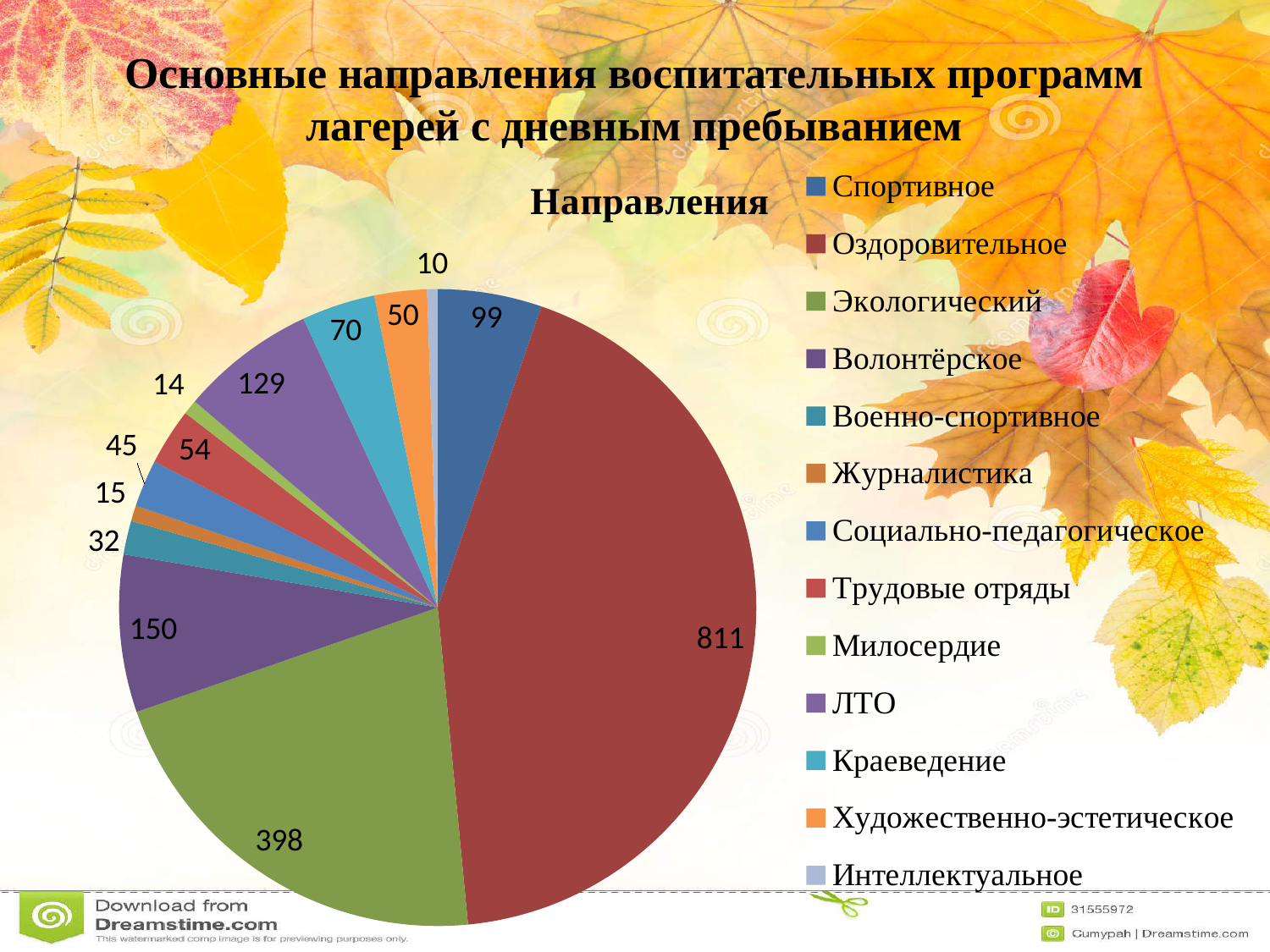
What is the value for Оздоровительное? 811 What is the difference between the values for Оздоровительное and Экологический? 413 What type of chart is shown on the slide? pie chart What is the title of the chart? Направления Which category has the largest slice of the pie? Оздоровительное What is the value for ЛТО? 129 What is the value for Экологический? 398 Which is larger, the value for Волонтёрское or the value for Спортивное? Волонтёрское What is the value for Краеведение? 70 Which category has the smallest slice of the pie? Интеллектуальное What is the difference between the values for Трудовые отряды and Социально-педагогическое? 9 How many entries does the chart legend list? 13